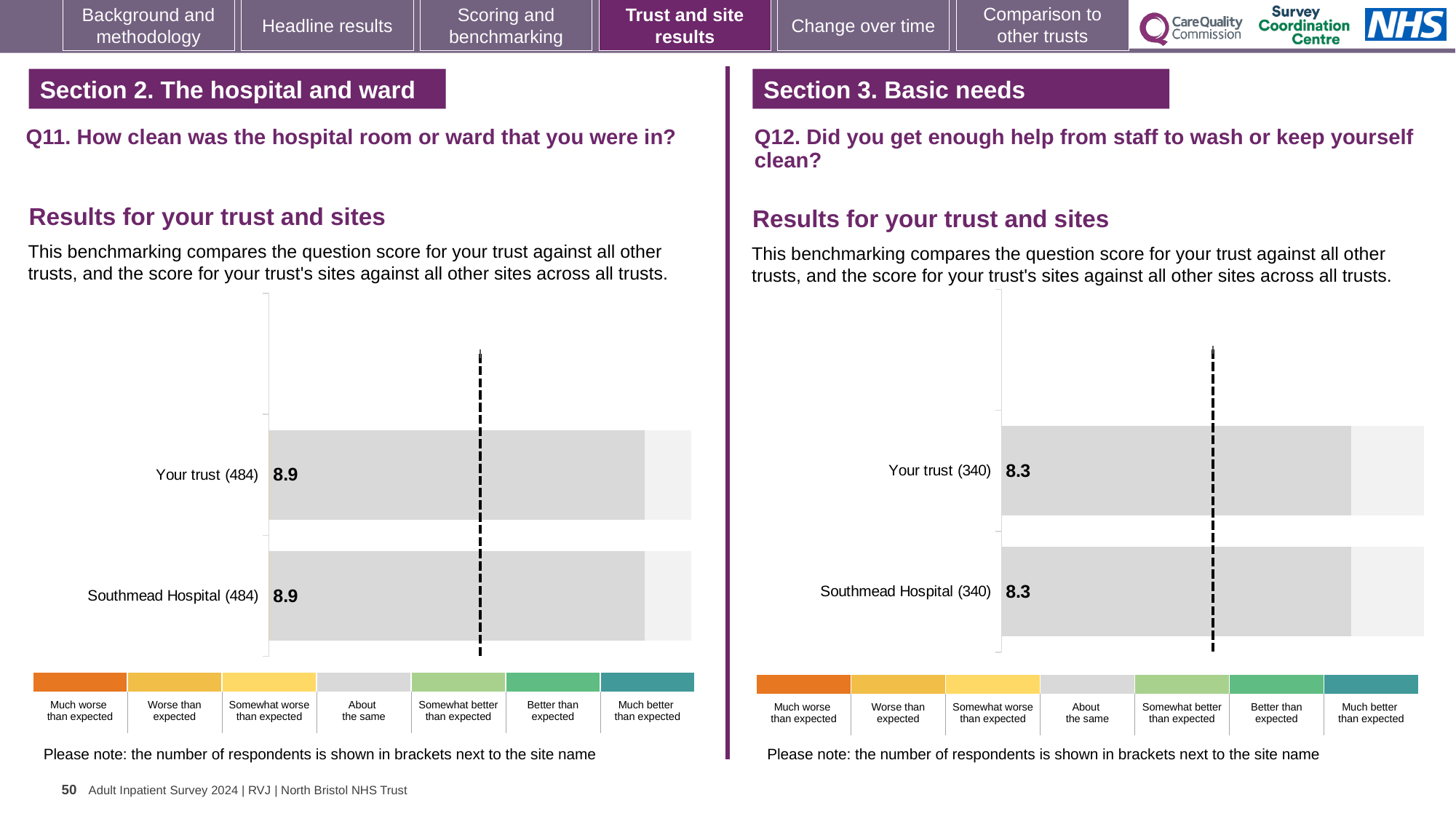
In the Q11 chart on the left, what is the difference between the score for Your trust and the score for Southmead Hospital? 0 How many categories does the colour key below the Q12 chart on the right list? 7 What kind of chart is the Q11 chart on the left? Bar chart In the Q12 chart on the right, how many respondents are shown in brackets for Southmead Hospital? 340 In the Q11 chart on the left, how many respondents are shown in brackets for Your trust? 484 In the Q11 chart on the left, what is the score for Your trust? 8.9 Is the Your trust score in the Q11 chart on the left larger or smaller than the Your trust score in the Q12 chart on the right? Larger In the Q12 chart on the right, what is the score for Your trust? 8.3 In the Q12 chart on the right, how many bars are plotted? 2 In the Q12 chart on the right, what is the score for Southmead Hospital? 8.3 In the colour key below the Q11 chart on the left, which category is shown in orange at the far left? Much worse than expected In the Q11 chart on the left, what is the score for Southmead Hospital? 8.9